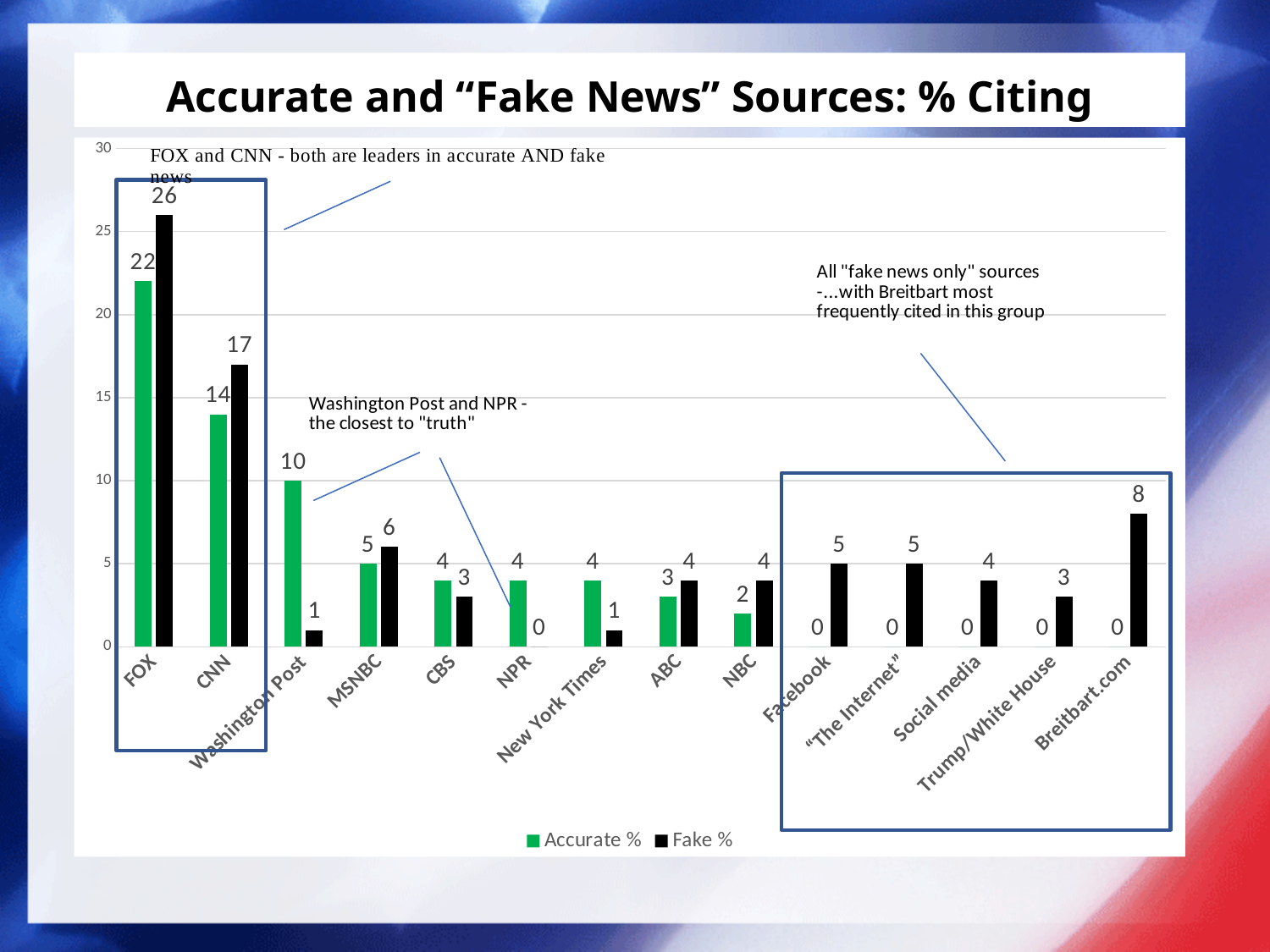
What is the difference between the Fake % and Accurate % values for FOX? 4 What is the difference between the Accurate % and Fake % values for Washington Post? 9 How many series does the legend list? 2 Which is larger, the Fake % value for Breitbart.com or the Fake % value for Facebook? Breitbart.com Which source has the highest Fake % value? FOX What kind of chart is shown on the slide? Bar chart What is the Fake % value for CNN? 17 What is the Accurate % value for FOX? 22 How many sources (categories) are shown on the x axis? 14 Which source has the highest Accurate % value? FOX Which is larger for MSNBC, the Accurate % value or the Fake % value? Fake % What is the Fake % value for Breitbart.com? 8